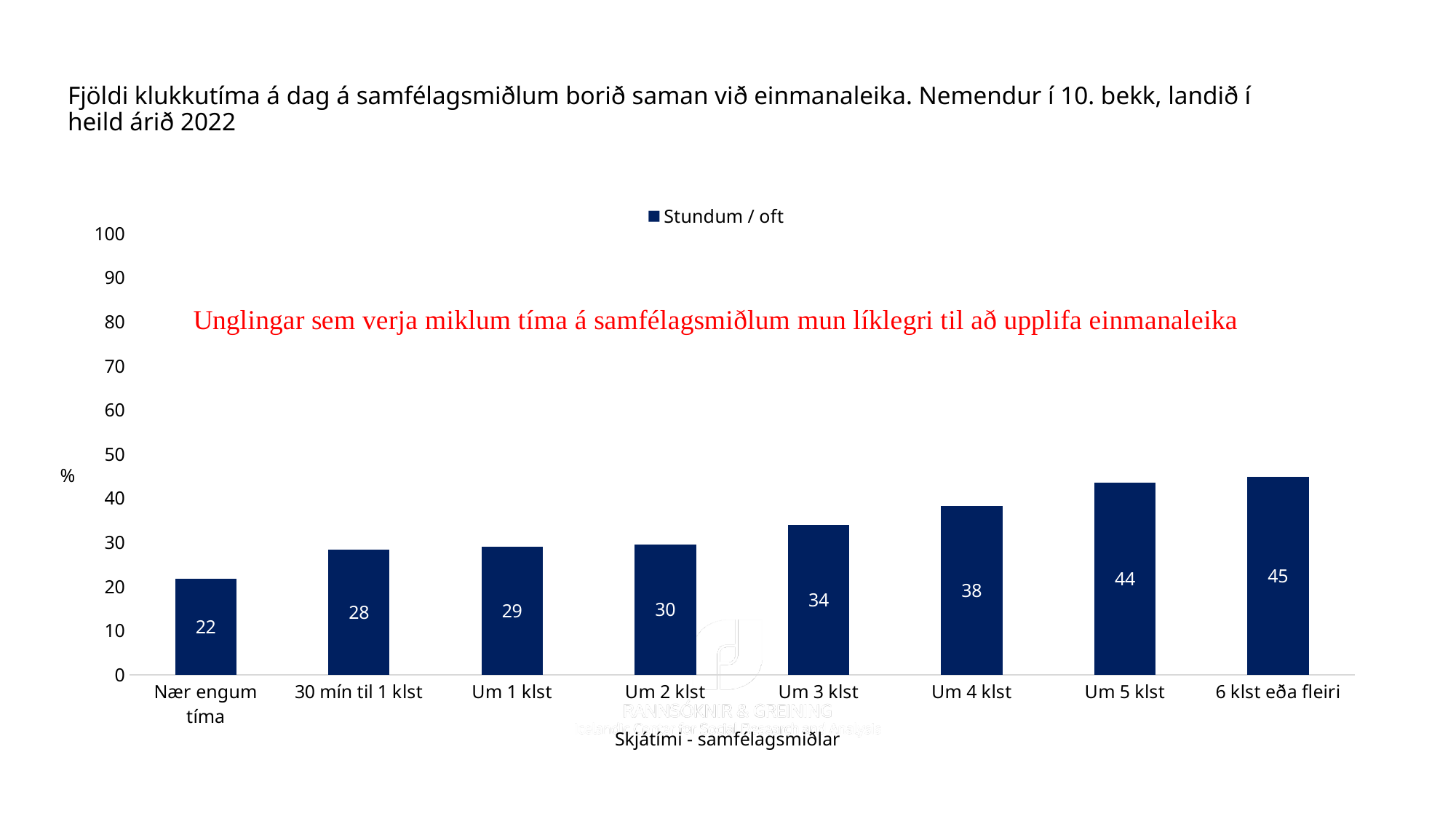
Which category has the lowest value? Nær engum tíma Which category has the highest value? 6 klst eða fleiri Which is larger, the value for "Um 4 klst" or the value for "Um 2 klst"? Um 4 klst Is the value for "Um 1 klst" greater or less than 50? less What is the value for "Nær engum tíma"? 22 What kind of chart is shown on the slide? bar chart What is the value for "Um 5 klst"? 44 What is the difference between the values for "6 klst eða fleiri" and "Nær engum tíma"? 23 How many categories are shown on the x axis? 8 How many series does the legend list? 1 What is the value for "Um 3 klst"? 34 Do the values rise or fall from left to right along the x axis? rise